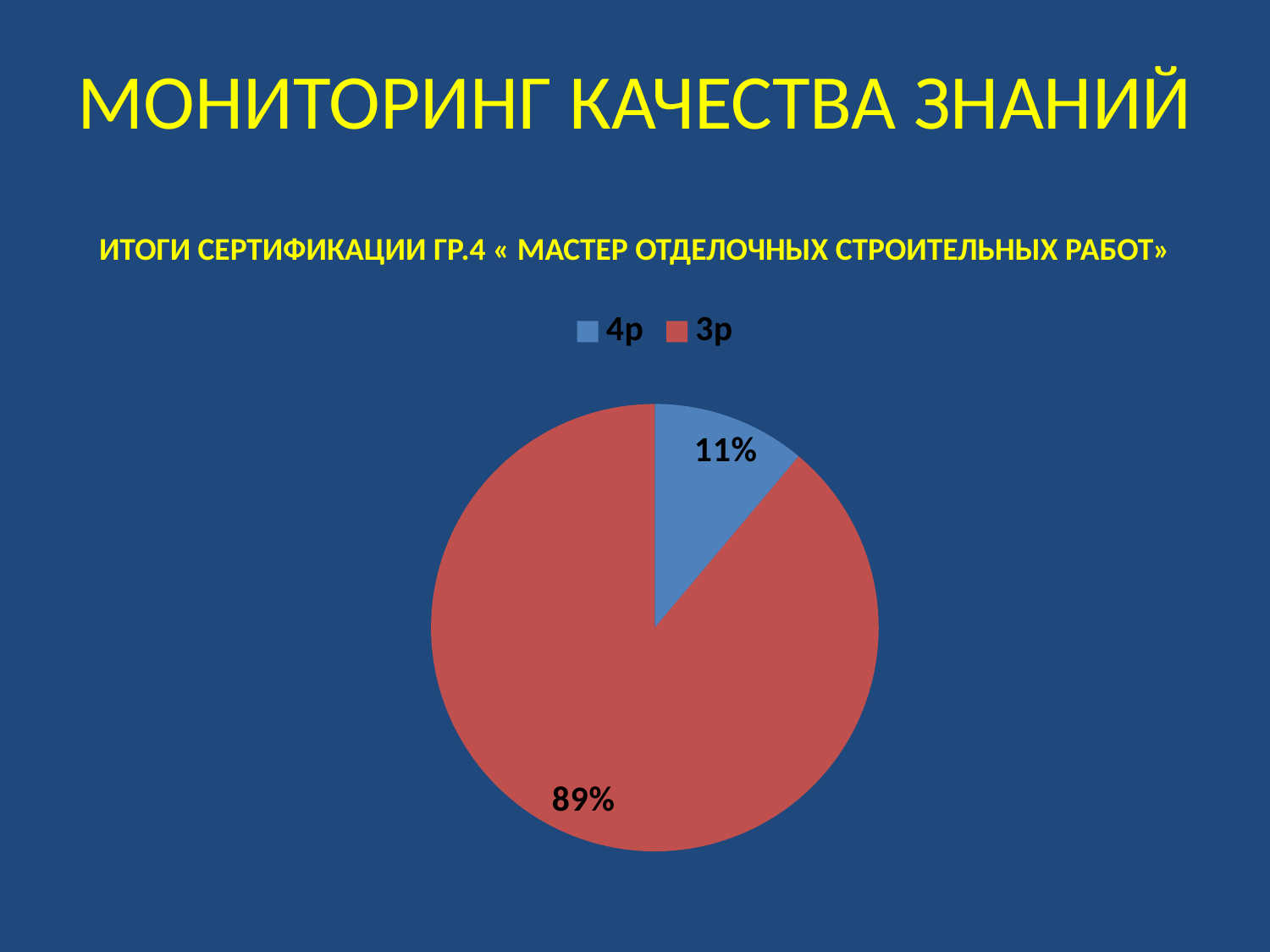
What share of the pie does the 4р slice represent? 11% What colour is the 3р slice? red What colour is the 4р slice? blue What kind of chart is shown on the slide? pie chart Which category has the largest slice of the pie? 3р What is the difference in percentage points between the 3р and 4р slices? 78% What share of the pie does the 3р slice represent? 89% How many slices does the pie chart have? 2 How many entries does the legend list? 2 Which slice is larger, 4р or 3р? 3р Which category has the smallest slice of the pie? 4р